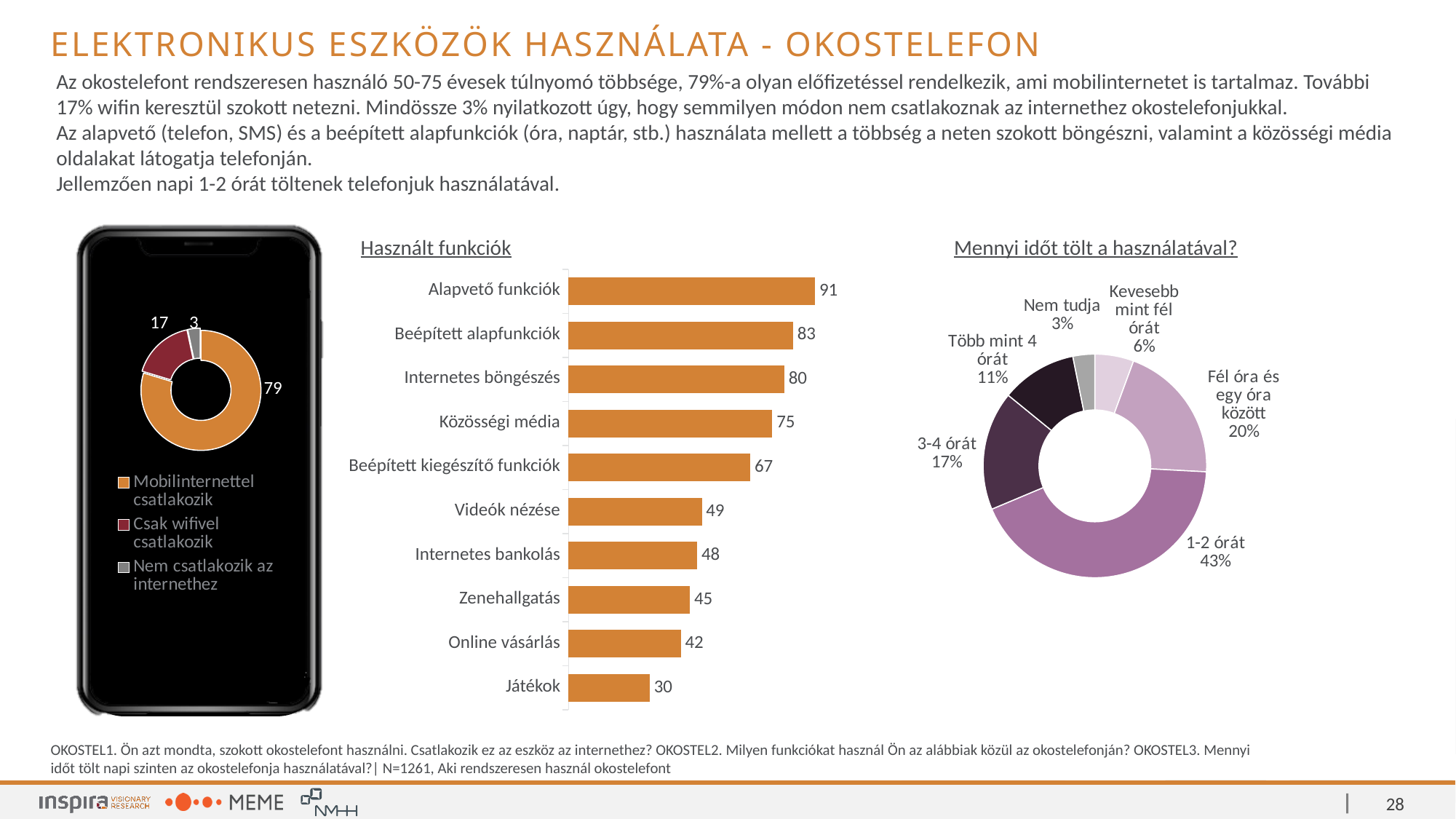
How many entries does the legend of the donut chart on the phone image list? 3 What type of chart is 'Használt funkciók'? Bar chart In the 'Használt funkciók' bar chart, which category has the highest value? Alapvető funkciók How many categories are shown in the 'Használt funkciók' bar chart? 10 In the 'Használt funkciók' bar chart, what is the difference between Alapvető funkciók and Játékok? 61 In the 'Mennyi időt tölt a használatával?' chart, which category has the smallest share? Nem tudja In the 'Használt funkciók' bar chart, which is larger: Videók nézése or Zenehallgatás? Videók nézése In the 'Mennyi időt tölt a használatával?' chart, what share is 1-2 órát? 43% In the 'Használt funkciók' bar chart, what is the value for Internetes böngészés? 80 In the 'Használt funkciók' bar chart, which category has the lowest value? Játékok In the 'Mennyi időt tölt a használatával?' chart, what is the difference between 3-4 órát and Több mint 4 órát? 6% In the donut chart on the phone image, what is the value for Csak wifivel csatlakozik? 17